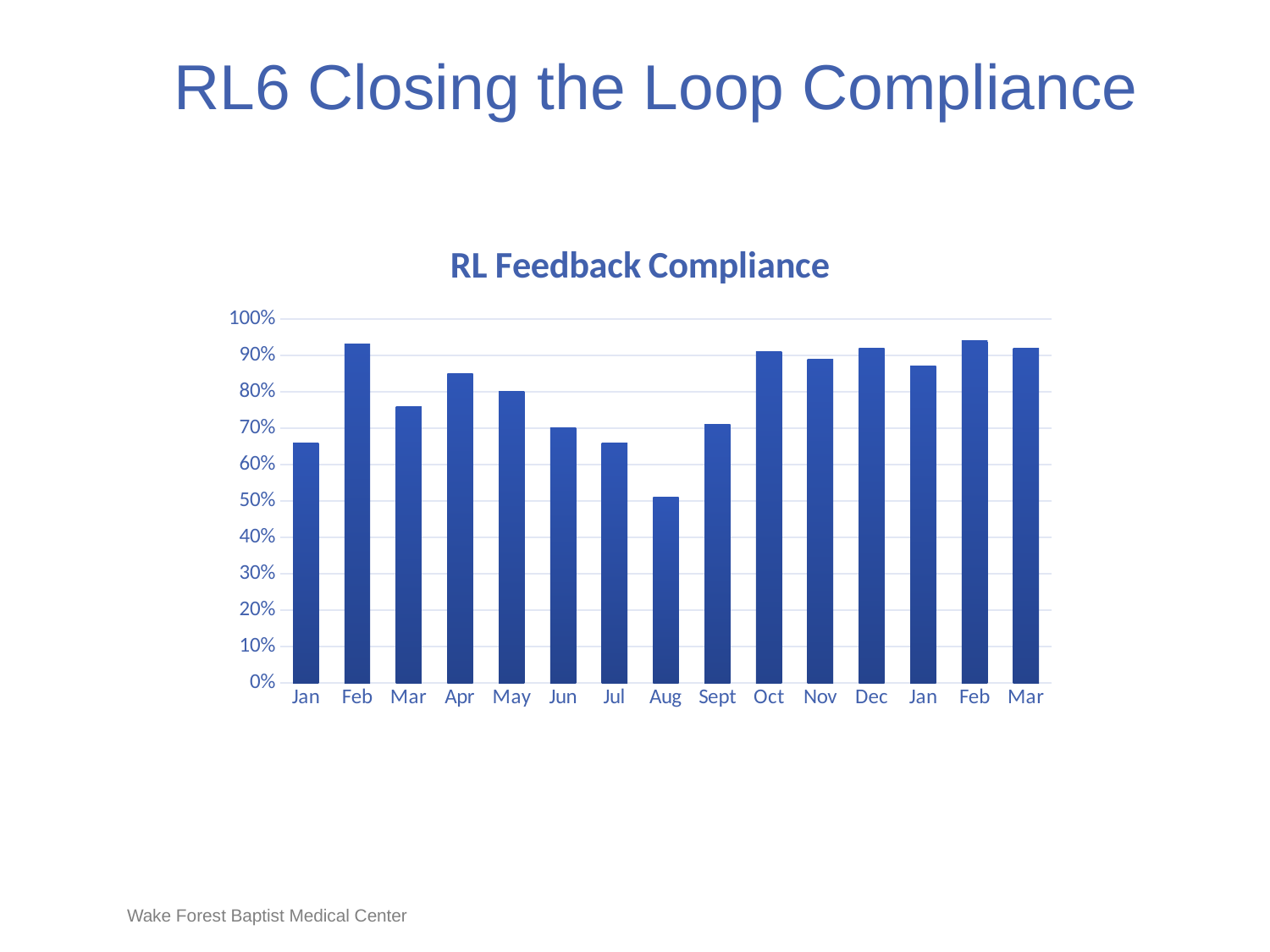
Is the value for Dec greater or less than 80%? greater What is the title of the chart? RL Feedback Compliance Which is larger, the value for Aug or the value for Sept? Sept Do the values rise or fall from Apr to Aug? fall Which is larger, the value for Apr or the value for May? Apr Is the value for Aug greater or less than 60%? less Is the value for Apr greater or less than 80%? greater What kind of chart is shown on the slide? bar chart How many bars are plotted in the chart? 15 Which month has the lowest compliance value? Aug Do the values rise or fall from Aug to Oct? rise